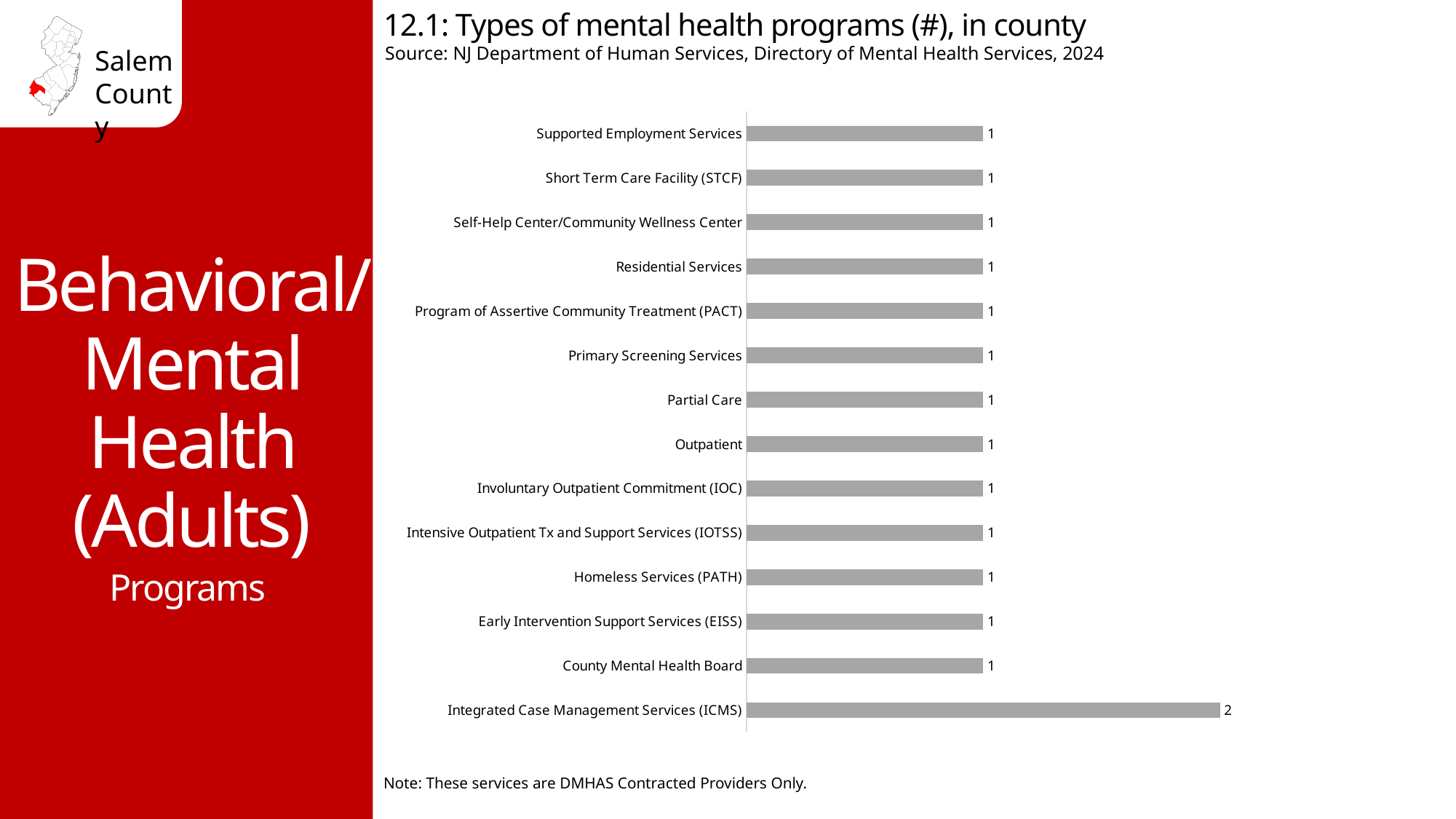
What is the value for Short Term Care Facility (STCF)? 1 What is the title of the chart? 12.1: Types of mental health programs (#), in county What kind of chart is shown on the slide? Bar chart What is the value for Program of Assertive Community Treatment (PACT)? 1 What is the value for Homeless Services (PATH)? 1 Which category has the highest value? Integrated Case Management Services (ICMS) What is the value for Partial Care? 1 What is the value for Integrated Case Management Services (ICMS)? 2 What is the source cited for the chart? NJ Department of Human Services, Directory of Mental Health Services, 2024 Which is larger, the value for Integrated Case Management Services (ICMS) or the value for Outpatient? Integrated Case Management Services (ICMS) How many categories are shown in the chart? 14 What is the difference between the values for Integrated Case Management Services (ICMS) and County Mental Health Board? 1